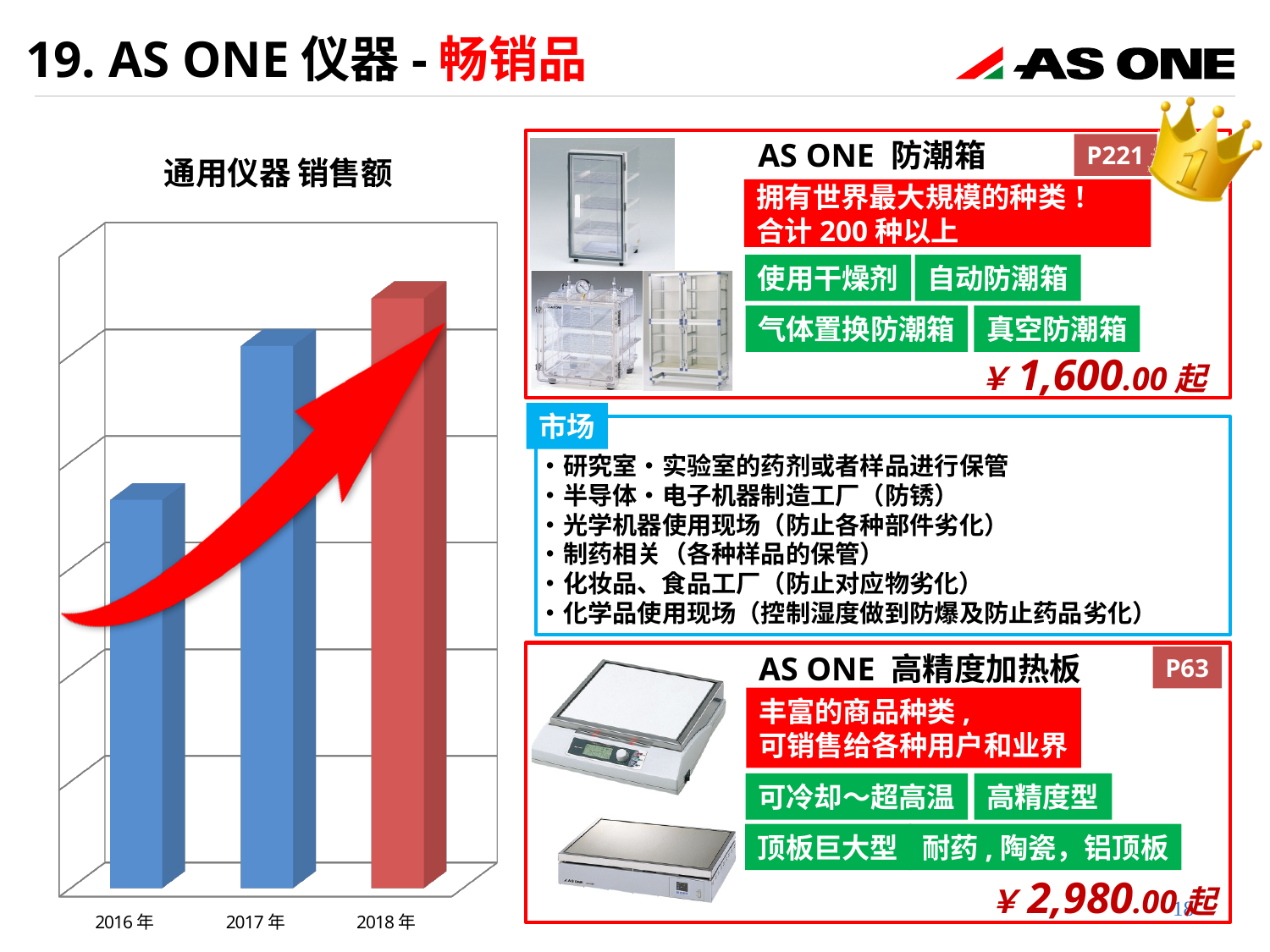
How many categories (years) are shown on the x axis of the chart? 3 Is the bar for 2017 年 taller or shorter than the bar for 2016 年? taller What is the title of the chart on the left of the slide? 通用仪器 销售额 Which year is the first category on the x axis of the chart? 2016 年 Do the bar values rise or fall from 2016 年 to 2018 年? rise What kind of chart is shown on the left of the slide? bar chart Which year has the highest bar in the chart? 2018 年 Which year has the lowest bar in the chart? 2016 年 Is the bar for 2018 年 taller or shorter than the bar for 2017 年? taller What colour is the bar for 2018 年 in the chart? red